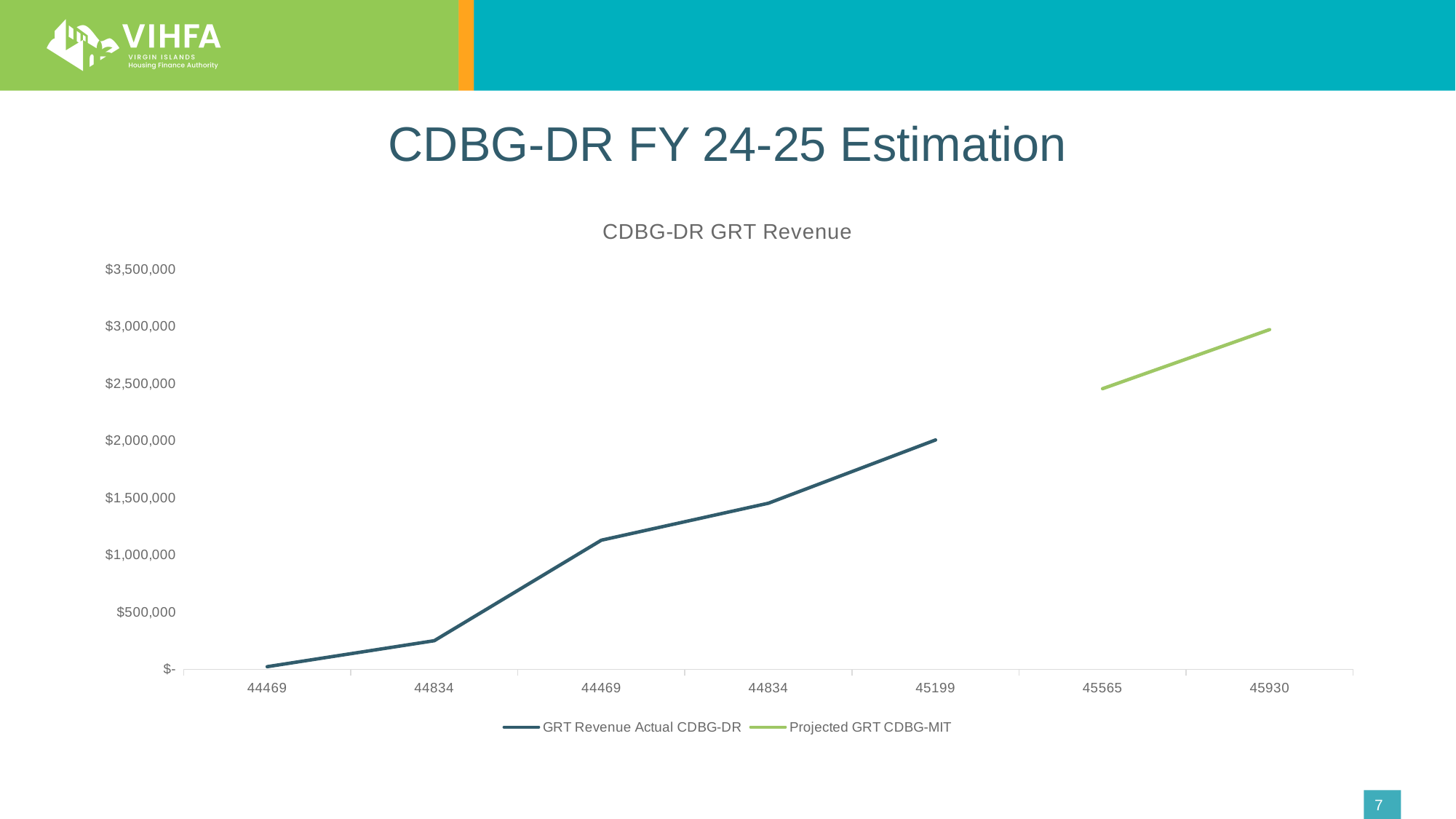
What is the title of the chart? CDBG-DR GRT Revenue Which is larger: the Projected GRT CDBG-MIT value at 45930 or the GRT Revenue Actual CDBG-DR value at 45199? Projected GRT CDBG-MIT at 45930 Is the GRT Revenue Actual CDBG-DR value at the second x-axis point (the first 44834) greater or less than $500,000? less Is the Projected GRT CDBG-MIT value at 45565 greater or less than $2,000,000? greater Does the GRT Revenue Actual CDBG-DR line rise or fall from left to right? rise What kind of chart is shown on the slide? line chart Is the GRT Revenue Actual CDBG-DR value at 45199 greater or less than $1,500,000? greater How many series does the legend list? 2 Does the Projected GRT CDBG-MIT line rise or fall from 45565 to 45930? rise How many categories are labelled along the x axis? 7 Which series is drawn in green? Projected GRT CDBG-MIT